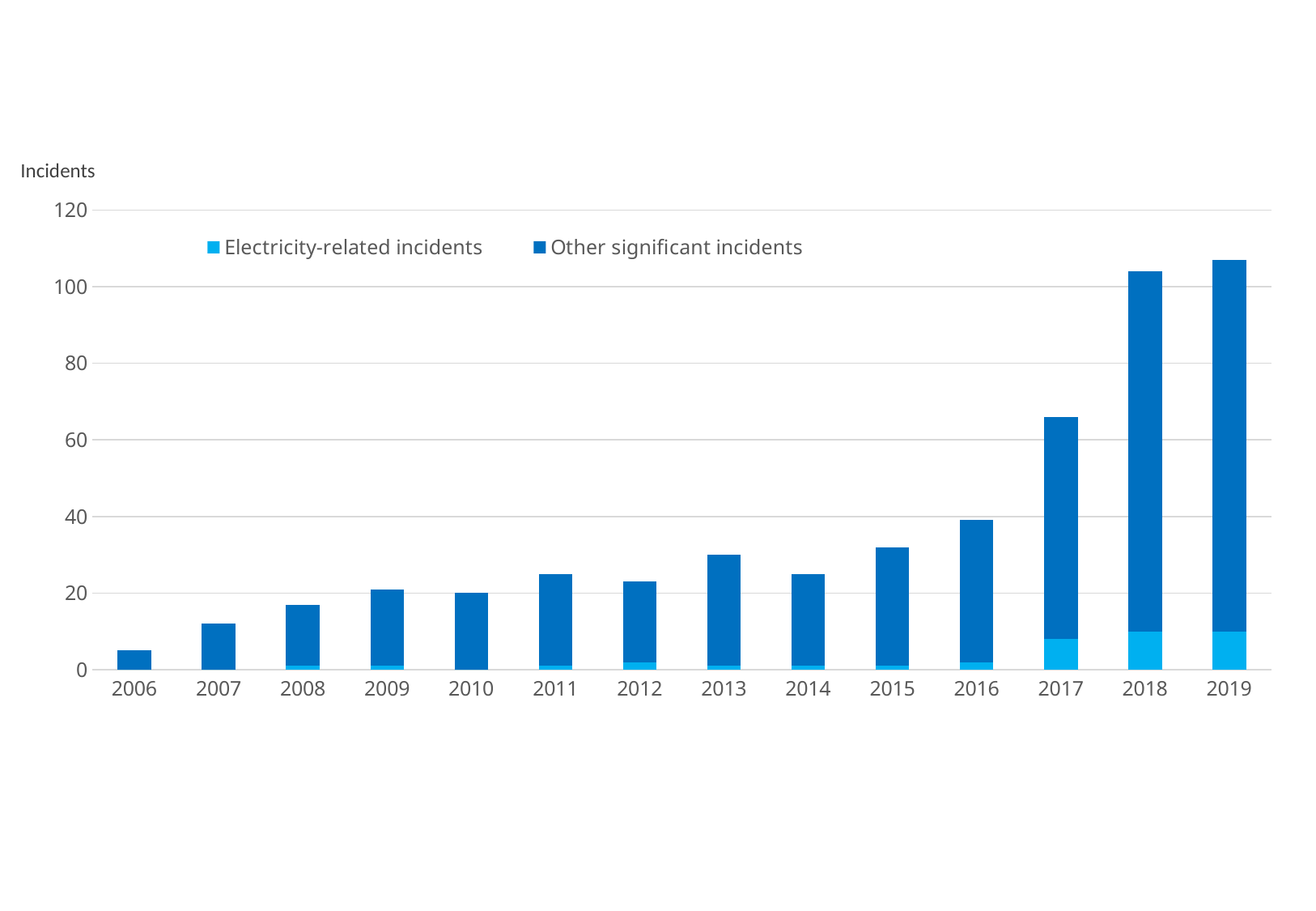
Is the total number of incidents in 2017 greater or less than 60? greater Do total incidents generally rise or fall from 2006 to 2019? rise Which year has the lowest total number of incidents? 2006 How many series does the legend list? 2 What label is shown on the vertical axis? Incidents Is the total number of incidents in 2018 greater or less than 100? greater Which year has the highest total number of incidents? 2019 Is the total number of incidents in 2007 greater or less than 20? less How many years are shown on the x axis? 14 What kind of chart is shown on the slide? bar chart Which year has more total incidents, 2013 or 2014? 2013